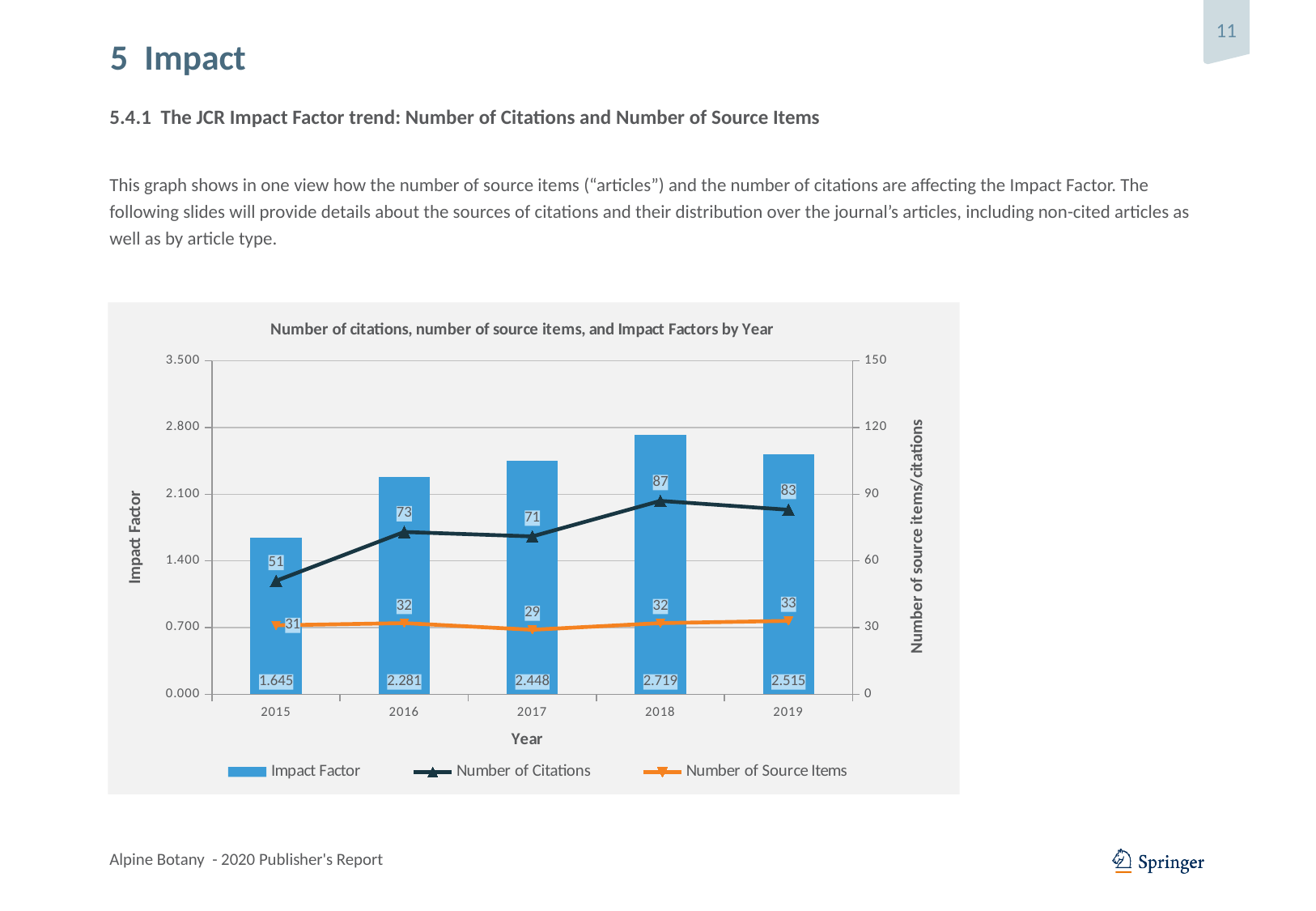
Which year has the highest Impact Factor? 2018 What kind of chart is used to show the Impact Factor series? Bar chart Does the Number of Citations rise or fall from 2015 to 2018? Rise What is the title of the chart? Number of citations, number of source items, and Impact Factors by Year Which is larger, the Impact Factor for 2017 or for 2019? 2019 How many series does the legend list? 3 How many years are shown on the x axis? 5 What is the Number of Source Items for 2017? 29 What is the Impact Factor for 2018? 2.719 What is the difference between the Number of Citations in 2018 and in 2015? 36 What is the Number of Citations for 2016? 73 Which year has the lowest Number of Citations? 2015